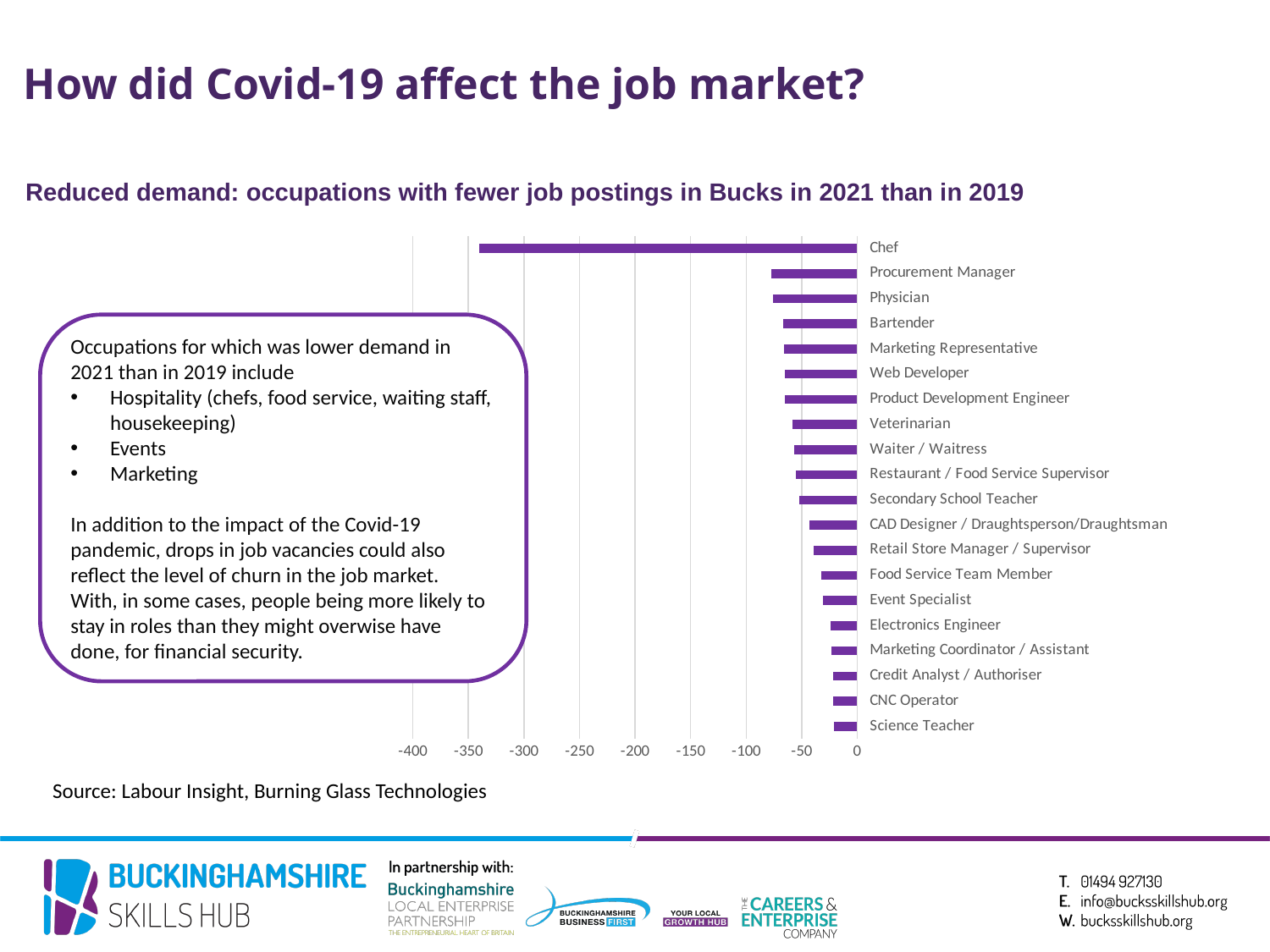
What is the lowest value shown on the horizontal axis? -400 Is the value for Bartender greater or less than -50? less How many occupations are plotted in the chart? 20 What is the title of the chart? Reduced demand: occupations with fewer job postings in Bucks in 2021 than in 2019 Is the value for Procurement Manager greater or less than -100? greater Is the value for Science Teacher greater or less than -50? greater Which occupation has the larger decrease in job postings, Bartender or Event Specialist? Bartender What kind of chart is shown on the slide? Bar chart Which occupation has the larger decrease in job postings, Chef or Procurement Manager? Chef Going down the list from Chef to Science Teacher, do the bars get longer or shorter? Shorter Which occupation shows the largest decrease in job postings (the longest bar)? Chef